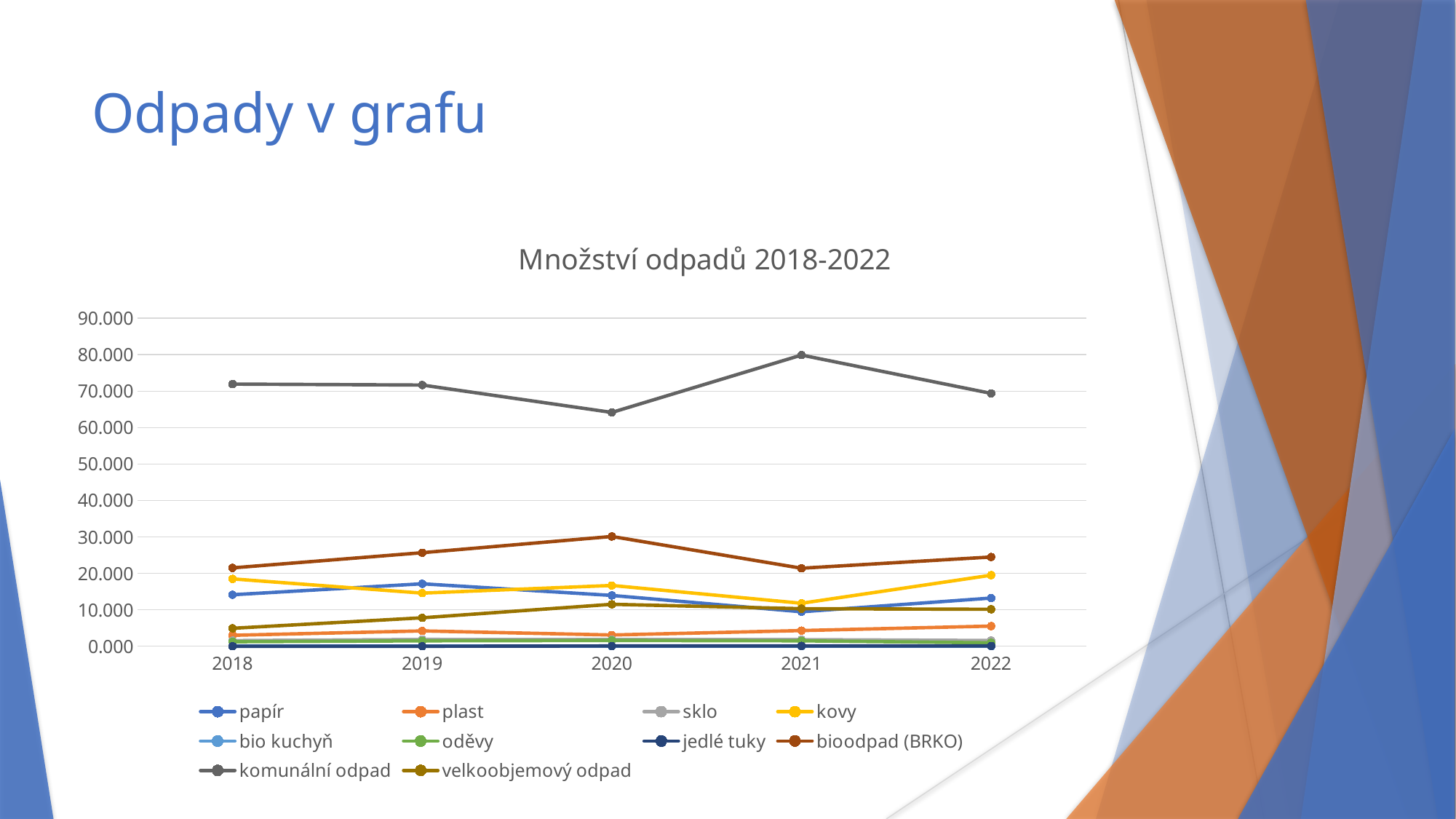
In which year is komunální odpad at its lowest? 2020 In which year is komunální odpad at its highest? 2021 What kind of chart is shown on the slide? line chart How many series does the legend list? 10 How many years are plotted along the x axis? 5 Is the value for plast in 2022 greater or less than 10.000? less Is the value for komunální odpad in 2021 greater or less than 70.000? greater In which year is bioodpad (BRKO) at its highest? 2020 What is the title of the chart? Množství odpadů 2018-2022 Which series has the highest values across the whole chart? komunální odpad Is the value for komunální odpad in 2020 greater or less than 70.000? less Which is larger: bioodpad (BRKO) in 2020 or bioodpad (BRKO) in 2021? bioodpad (BRKO) in 2020